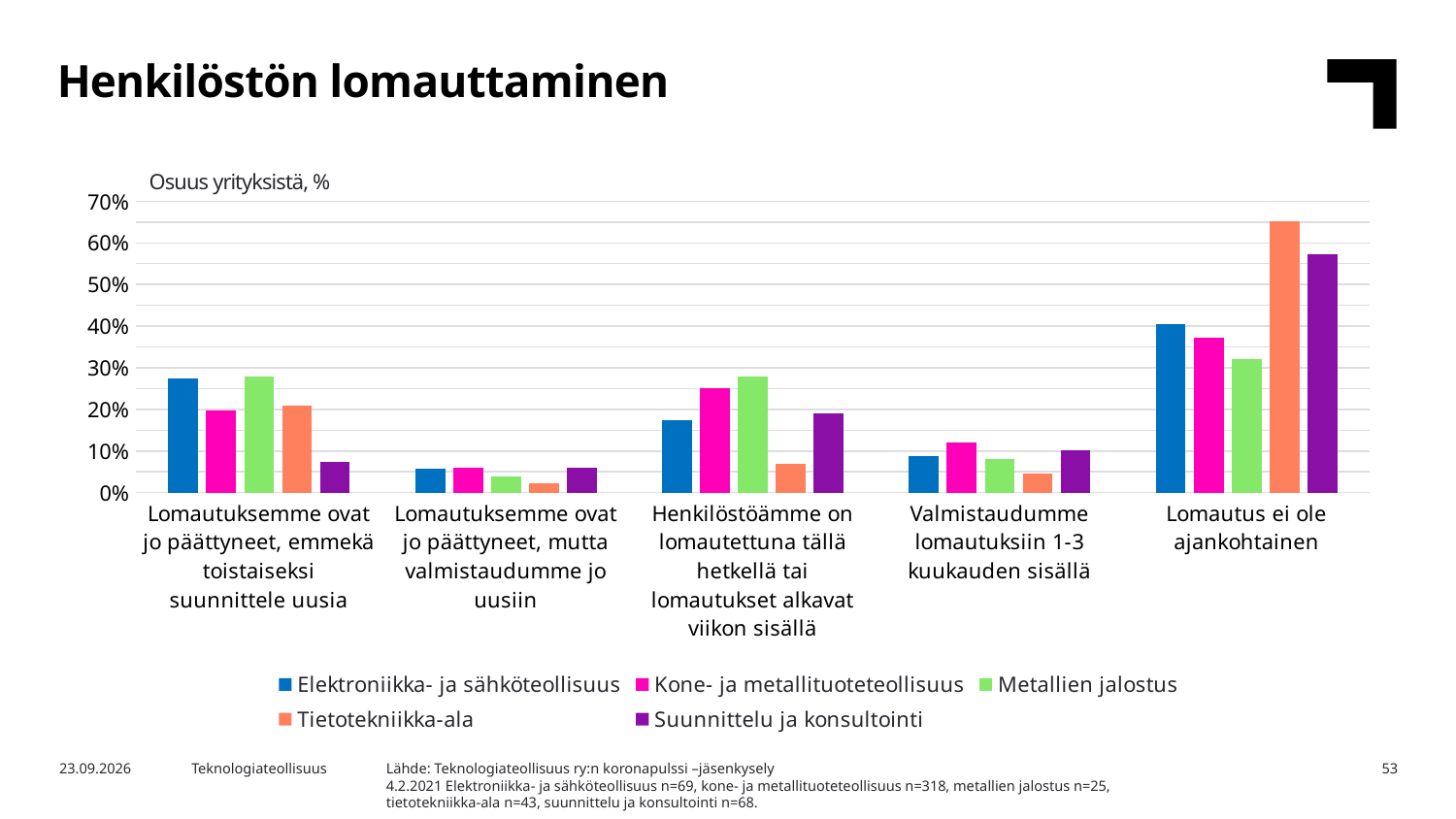
In which category does Tietotekniikka-ala have its highest value? Lomautus ei ole ajankohtainen Is the value for Tietotekniikka-ala in the category "Lomautus ei ole ajankohtainen" greater or less than 60%? greater How many series does the chart's legend list? 5 For the category "Lomautus ei ole ajankohtainen", which series has the highest value? Tietotekniikka-ala In the category "Henkilöstöämme on lomautettuna tällä hetkellä tai lomautukset alkavat viikon sisällä", which is larger: Kone- ja metallituoteteollisuus or Tietotekniikka-ala? Kone- ja metallituoteteollisuus Is the value for Metallien jalostus in the category "Lomautuksemme ovat jo päättyneet, mutta valmistaudumme jo uusiin" greater or less than 10%? less How many categories are shown on the x axis of the chart? 5 For the category "Lomautuksemme ovat jo päättyneet, emmekä toistaiseksi suunnittele uusia", which series has the lowest value? Suunnittelu ja konsultointi Is the value for Suunnittelu ja konsultointi in the category "Lomautus ei ole ajankohtainen" greater or less than 50%? greater What kind of chart is shown on the slide? Bar chart What label is shown above the vertical axis of the chart? Osuus yrityksistä, %